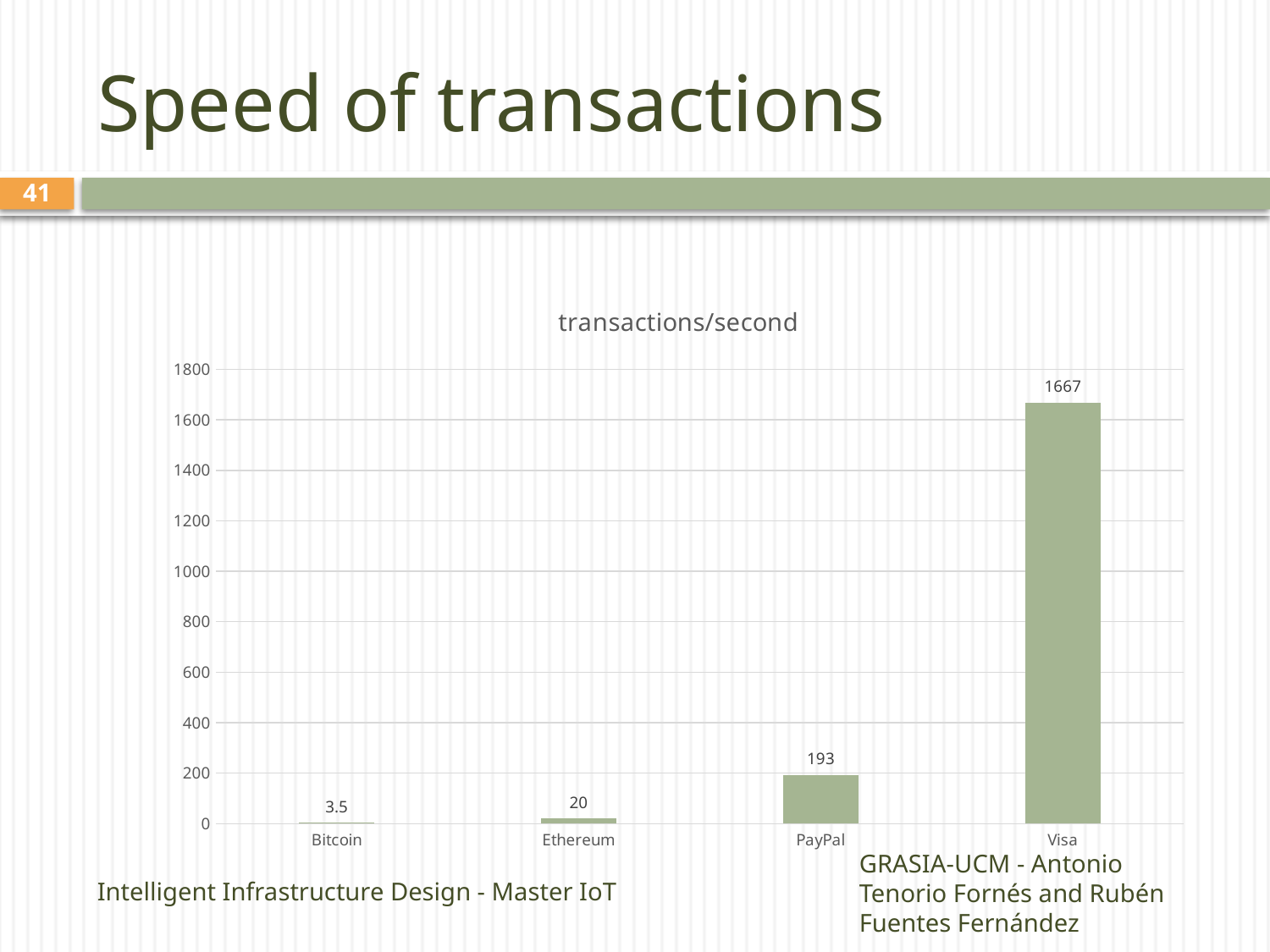
What is the value for Ethereum? 20 Which is larger, the value for PayPal or the value for Ethereum? PayPal Which category has the lowest value? Bitcoin Is the value for Visa greater or less than 1600? greater How many categories are shown on the x axis? 4 What is the value for PayPal? 193 What is the value for Bitcoin? 3.5 What is the title of the chart? transactions/second What is the difference between the values for Ethereum and Bitcoin? 16.5 Which category has the highest value? Visa What is the difference between the values for Visa and PayPal? 1474 What is the value for Visa? 1667